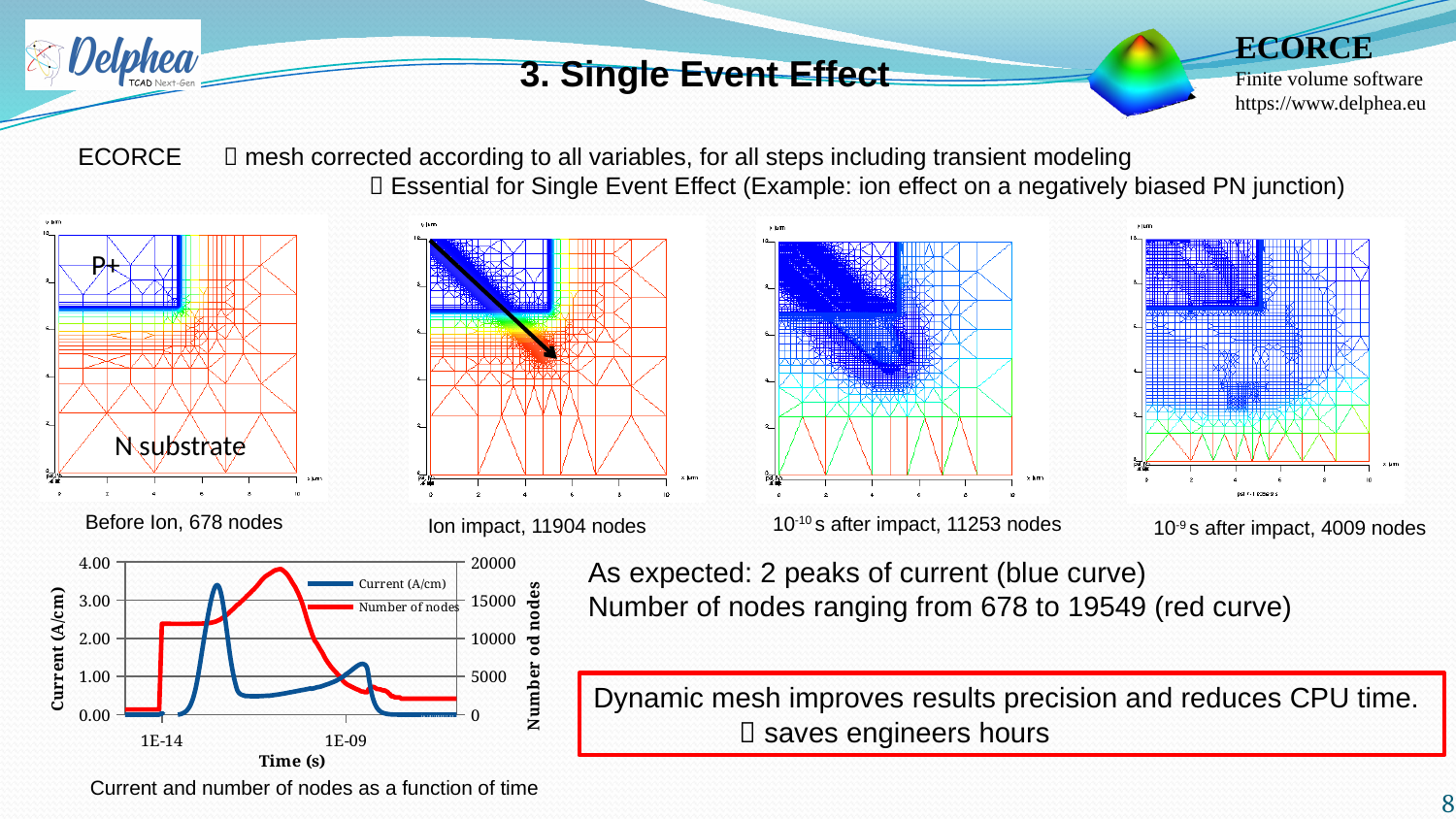
In the 'Current and number of nodes as a function of time' chart, which colour is the 'Current (A/cm)' series drawn in? blue In the 'Current and number of nodes as a function of time' chart, is the highest value of the 'Number of nodes' curve greater or less than 15000? greater In the 'Current and number of nodes as a function of time' chart, does the 'Number of nodes' curve rise or fall between 1E-14 and its peak? rise In the 'Current and number of nodes as a function of time' chart, is the final value of the 'Number of nodes' curve at the right end greater or less than 5000? less What kind of chart is 'Current and number of nodes as a function of time'? line chart In the 'Current and number of nodes as a function of time' chart, is the second peak of the 'Current (A/cm)' curve greater or less than 2.00? less How many series does the legend of the 'Current and number of nodes as a function of time' chart list? 2 What is the label of the x axis of the 'Current and number of nodes as a function of time' chart? Time (s) In the 'Current and number of nodes as a function of time' chart, does the 'Number of nodes' curve rise or fall after reaching its peak? fall How many peaks does the 'Current (A/cm)' curve show in the 'Current and number of nodes as a function of time' chart? 2